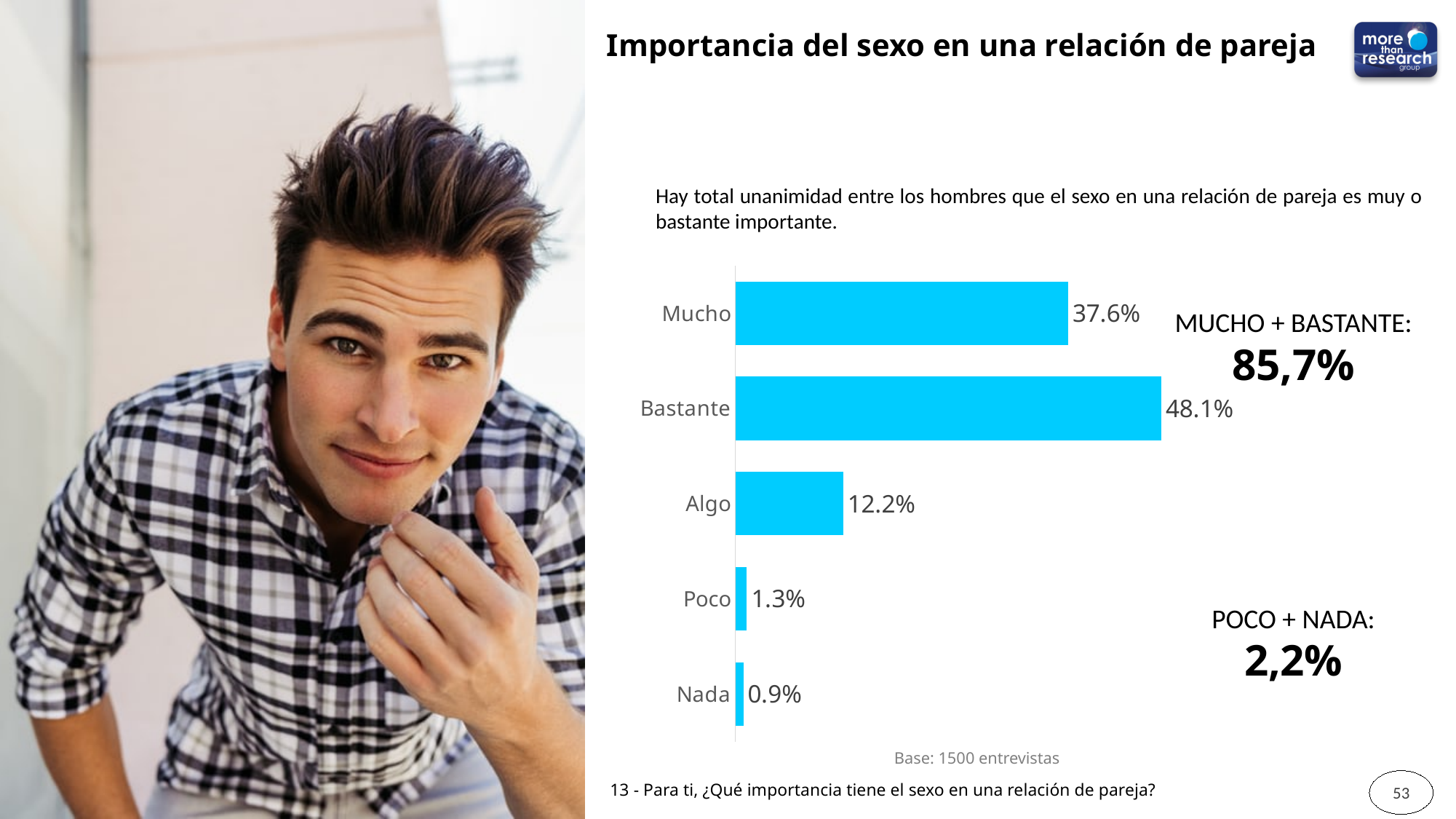
How many categories are shown in the chart? 5 What is the value for Algo? 12.2% Which is larger, the value for Algo or the value for Poco? Algo Which category has the lowest value? Nada What is the difference between the values for Bastante and Mucho? 10.5% What kind of chart is shown on the slide? Bar chart What is the value for Mucho? 37.6% What is the value for Nada? 0.9% Which category has the highest value? Bastante What is the value for Bastante? 48.1% What is the combined value shown for MUCHO + BASTANTE? 85,7% What is the base (number of interviews) stated below the chart? 1500 entrevistas